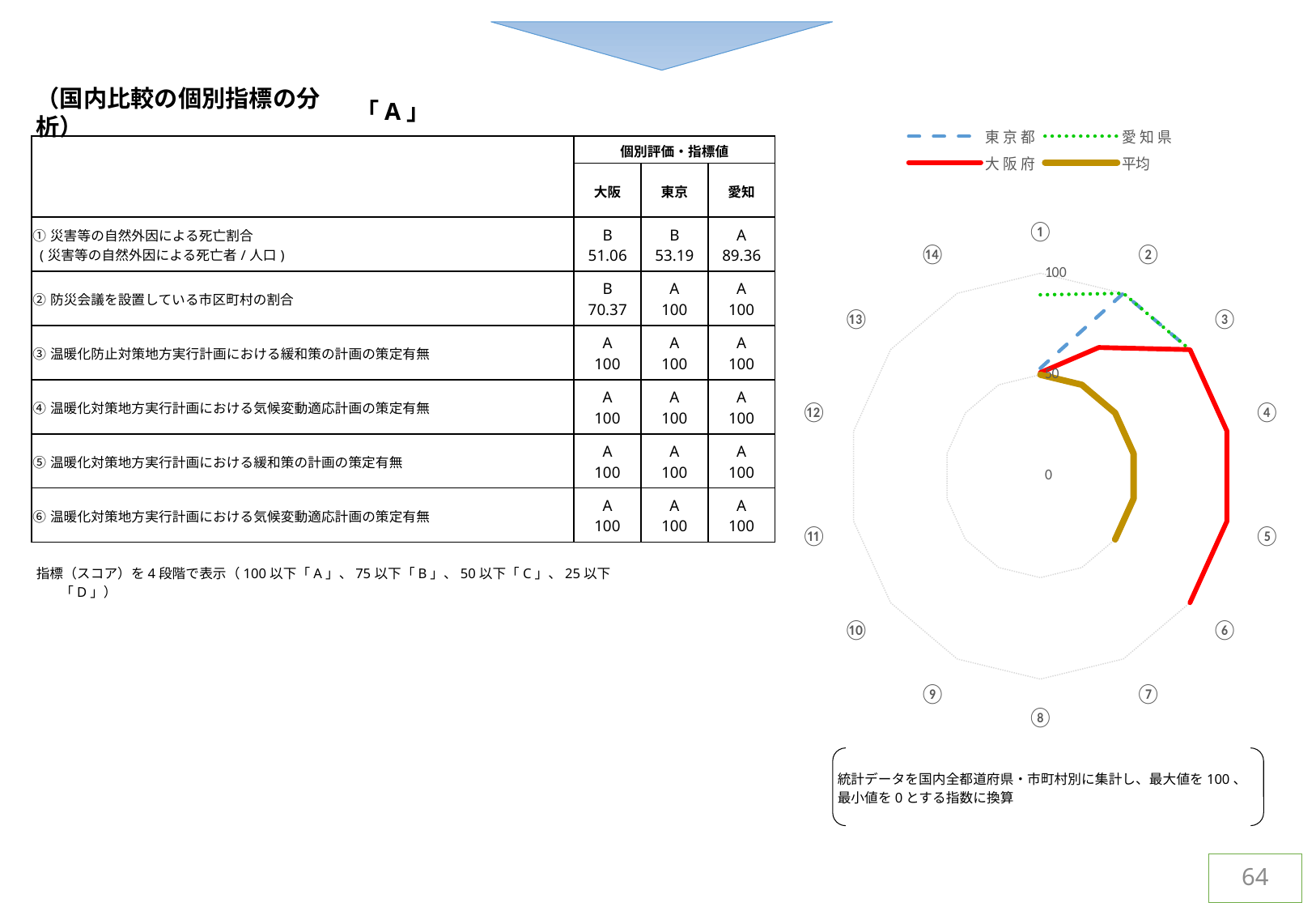
How many numbered categories (axes) does the radar chart have? 14 Which series in the radar chart is drawn as a solid red line? 大阪府 In the radar chart, is the value of 平均 at category ⑥ greater or less than 100? less In the radar chart, which is larger at category ⑥: 大阪府 or 平均? 大阪府 In the radar chart, is the value of 大阪府 at category ④ greater or less than 50? greater How many series does the legend of the radar chart list? 4 In the radar chart, is the value of 愛知県 at category ① greater or less than 50? greater In the radar chart, which series has the lowest value at category ⑤? 平均 What kind of chart is shown on the right side of the slide? radar chart What is the maximum value shown on the radar chart's axis scale? 100